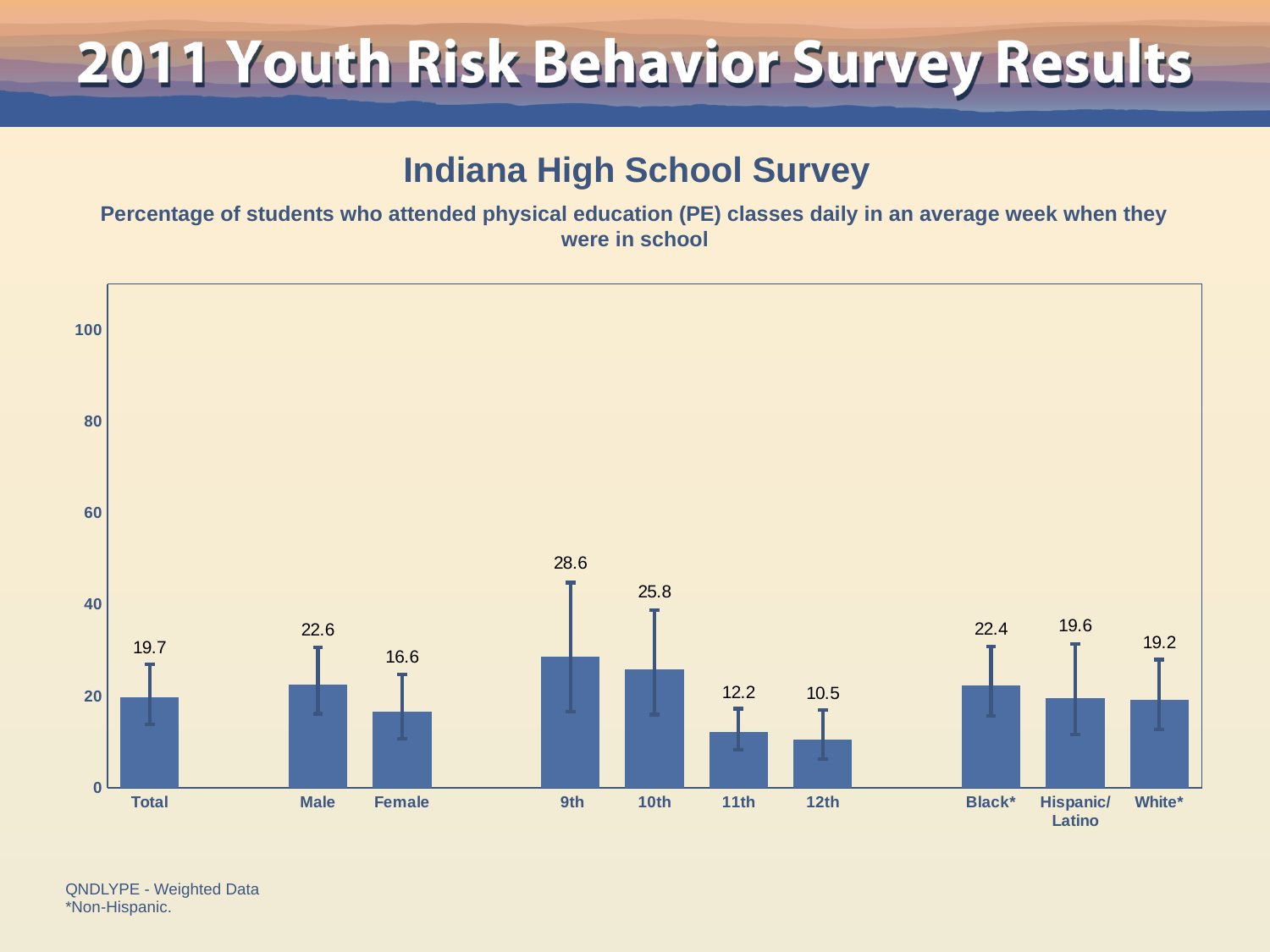
What kind of chart is this? bar chart What is the value for Hispanic/Latino? 19.6 Which category has the lowest value? 12th Is the value for 10th greater or less than 20? greater Which category has the highest value? 9th What is the value for Total? 19.7 What is the difference between the values for 9th and 12th? 18.1 Which is larger, the value for Black* or the value for White*? Black* Do the values rise or fall from 9th grade to 12th grade? fall How many categories are shown on the x axis? 10 What is the difference between the values for Male and Female? 6.0 What is the value for 9th grade? 28.6